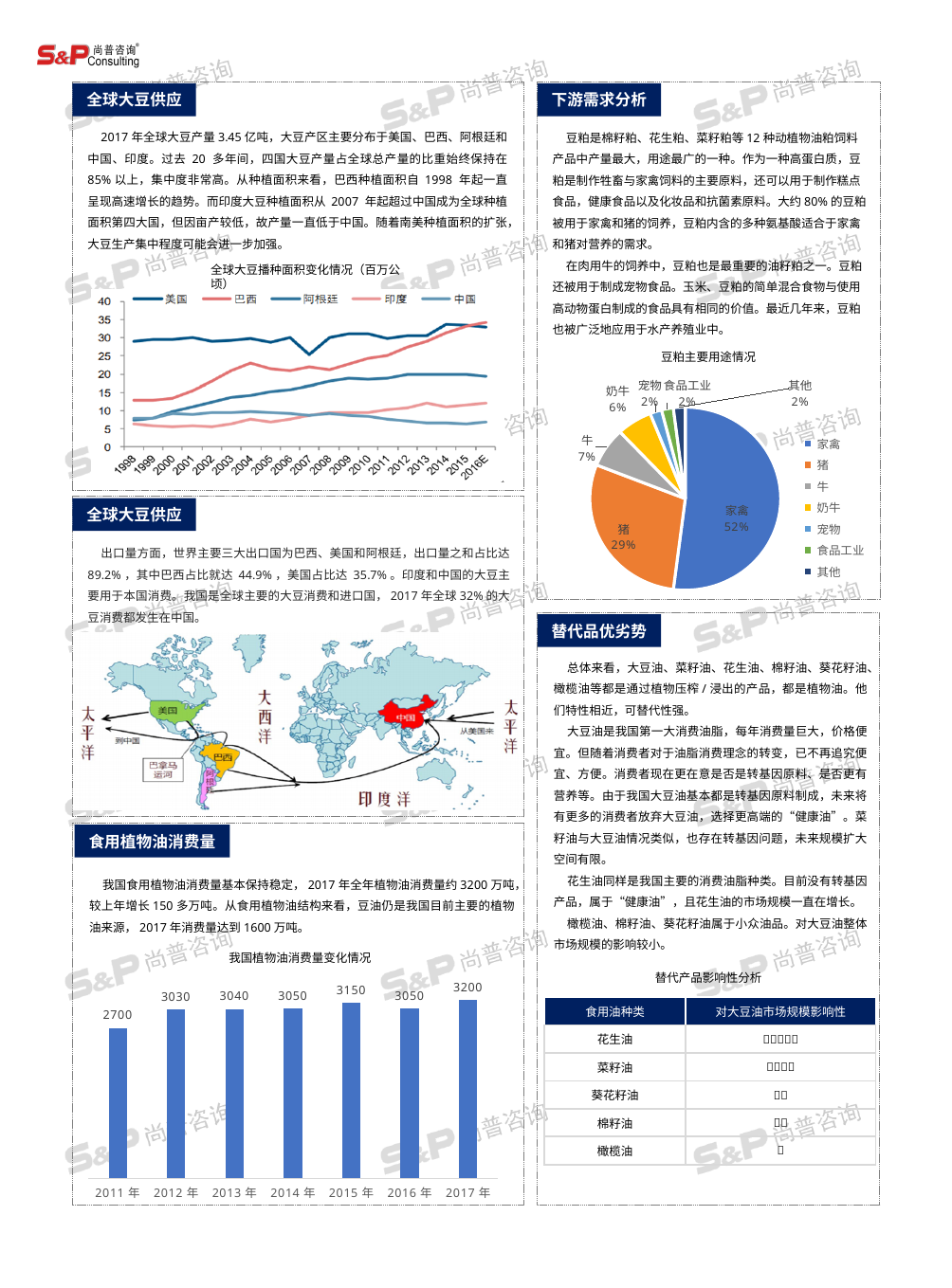
In the pie chart titled 豆粕主要用途情况, which is larger, 牛 or 奶牛? 牛 In the pie chart titled 豆粕主要用途情况, what is the percentage for 猪? 29% In the bar chart titled 我国植物油消费量变化情况, what is the difference between the values for 2017 年 and 2016 年? 150 In the bar chart titled 我国植物油消费量变化情况, what is the value for 2017 年? 3200 In the line chart titled 全球大豆播种面积变化情况, is the value for 中国 in 2016E greater or less than 10? less In the line chart titled 全球大豆播种面积变化情况, does the 巴西 series rise or fall from 1998 to 2016E? rise In the pie chart titled 豆粕主要用途情况, what share does 家禽 have? 52% In the bar chart titled 我国植物油消费量变化情况, which year has the lowest value? 2011 年 In the line chart titled 全球大豆播种面积变化情况, how many series does the legend list? 5 In the pie chart titled 豆粕主要用途情况, how many categories does the legend list? 7 In the bar chart titled 我国植物油消费量变化情况, what is the value for 2011 年? 2700 In the bar chart titled 我国植物油消费量变化情况, how many bars are plotted? 7